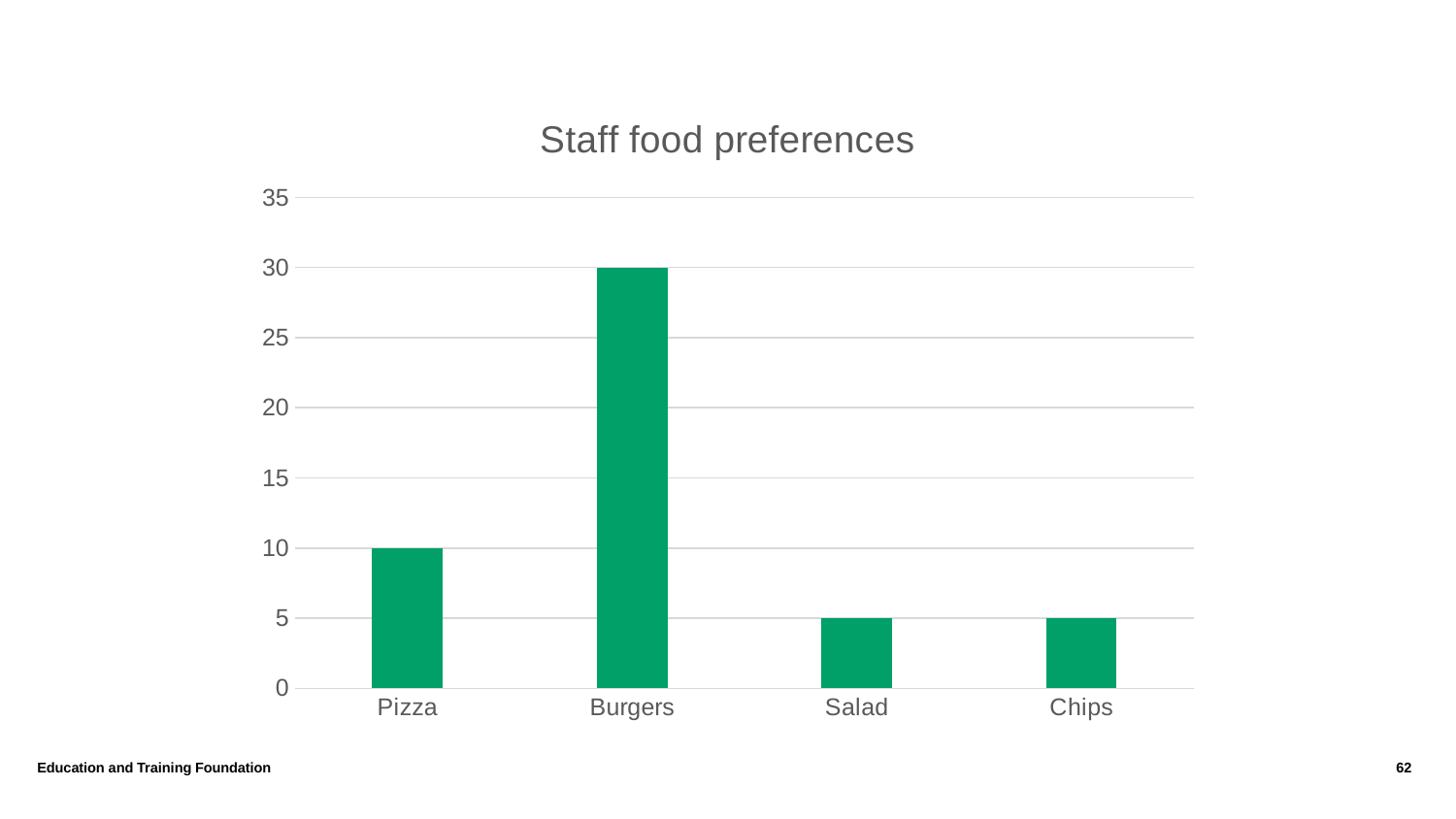
Is the value for Burgers greater or less than 25? greater What is the value for Chips? 5 What is the value for Pizza? 10 Which is larger, the value for Pizza or the value for Chips? Pizza What is the value for Salad? 5 Which category has the highest value? Burgers What is the value for Burgers? 30 What kind of chart is shown on the slide? Bar chart What is the difference between the values for Pizza and Salad? 5 What is the difference between the values for Burgers and Pizza? 20 What is the title of the chart? Staff food preferences How many categories are shown on the x axis? 4